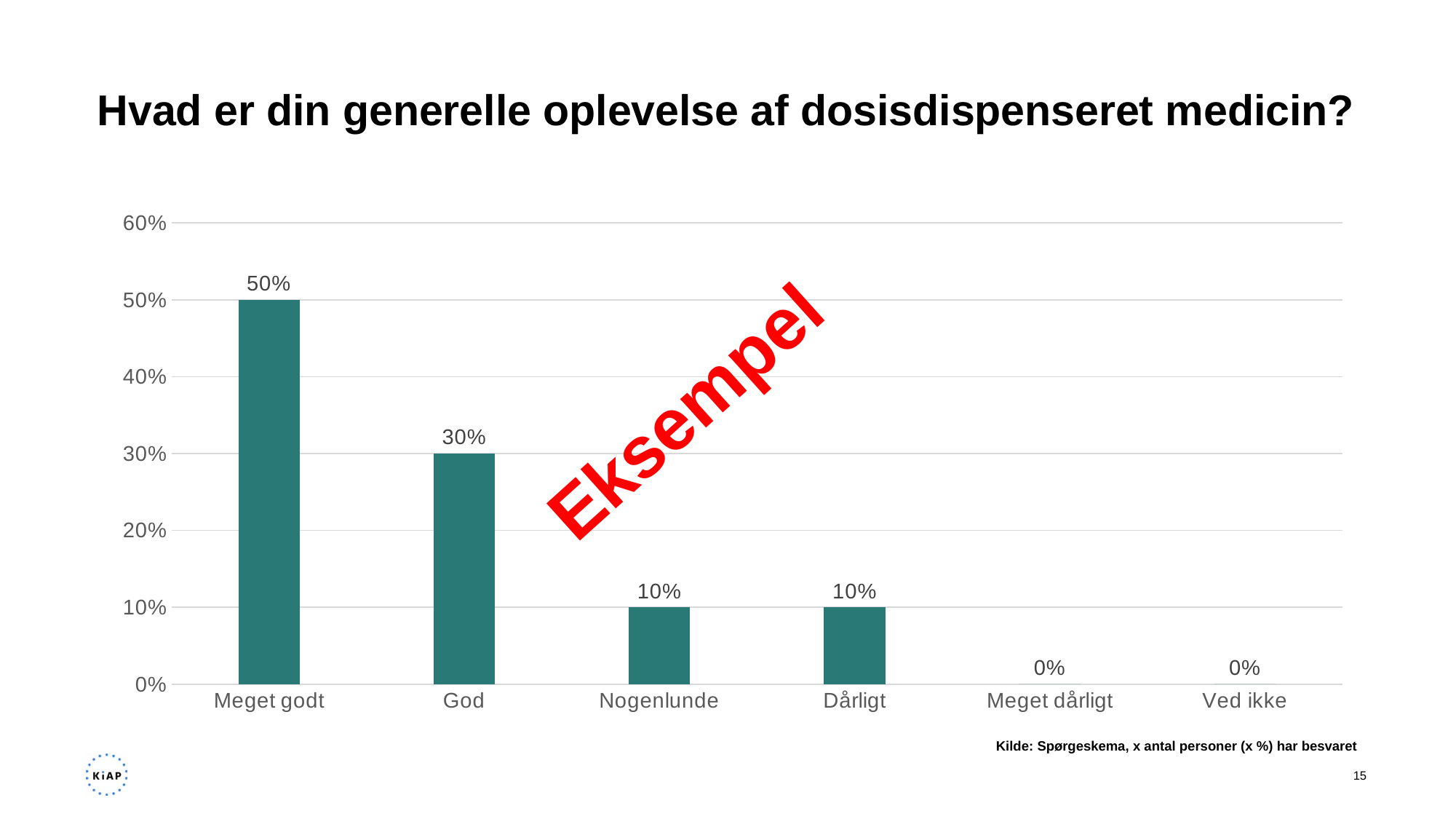
What is the value for Ved ikke? 0% What is the title of the slide? Hvad er din generelle oplevelse af dosisdispenseret medicin? What is the value for Meget godt? 50% What is the value for God? 30% Is the value for God greater or less than 40%? less What is the value for Nogenlunde? 10% Do the values rise or fall from Meget godt to Dårligt along the x axis? fall What is the difference between the values for Meget godt and God? 20% What kind of chart is shown on the slide? bar chart Which is larger, the value for God or the value for Dårligt? God How many categories are shown on the x axis? 6 Which category has the highest value? Meget godt